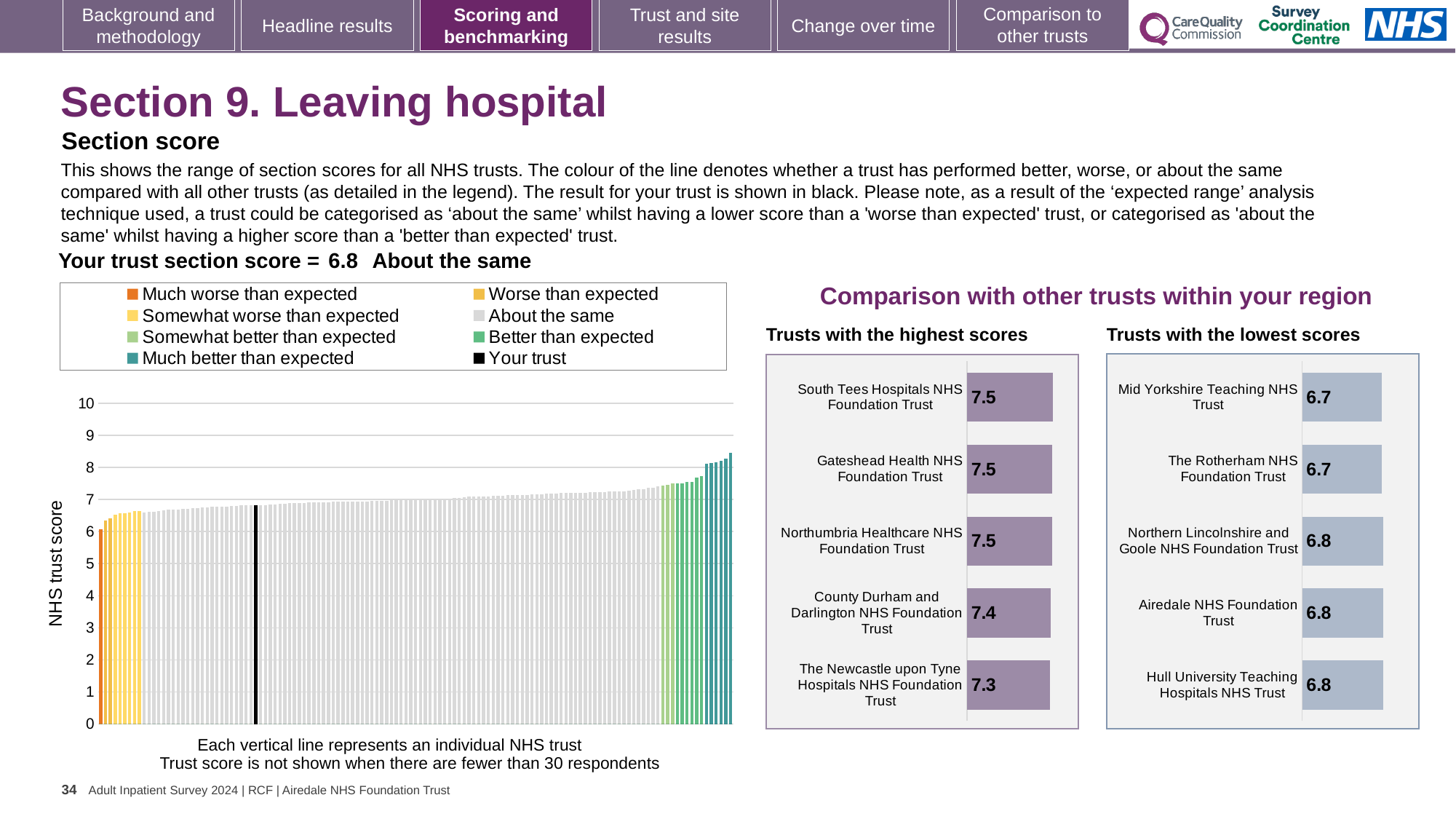
In the 'Trusts with the highest scores' chart, what is the score for County Durham and Darlington NHS Foundation Trust? 7.4 In the large chart on the left, is the value of the tallest bar greater or less than 8? greater In the large chart on the left, how many entries does the legend list? 8 What kind of chart is the large chart on the left showing NHS trust scores? bar chart In the large chart on the left, what is the section score for your trust (the black bar)? 6.8 In the 'Trusts with the lowest scores' chart, which has the higher score: Airedale NHS Foundation Trust or The Rotherham NHS Foundation Trust? Airedale NHS Foundation Trust In the large chart on the left, do the bar values rise or fall from left to right? rise In the 'Trusts with the lowest scores' chart, what is the score for Mid Yorkshire Teaching NHS Trust? 6.7 In the large chart on the left, what is the label on the vertical axis? NHS trust score In the 'Trusts with the highest scores' chart, how many trusts are shown? 5 In the 'Trusts with the highest scores' chart, what is the difference between the scores of South Tees Hospitals NHS Foundation Trust and The Newcastle upon Tyne Hospitals NHS Foundation Trust? 0.2 In the 'Trusts with the highest scores' chart, which trust has the lowest score? The Newcastle upon Tyne Hospitals NHS Foundation Trust